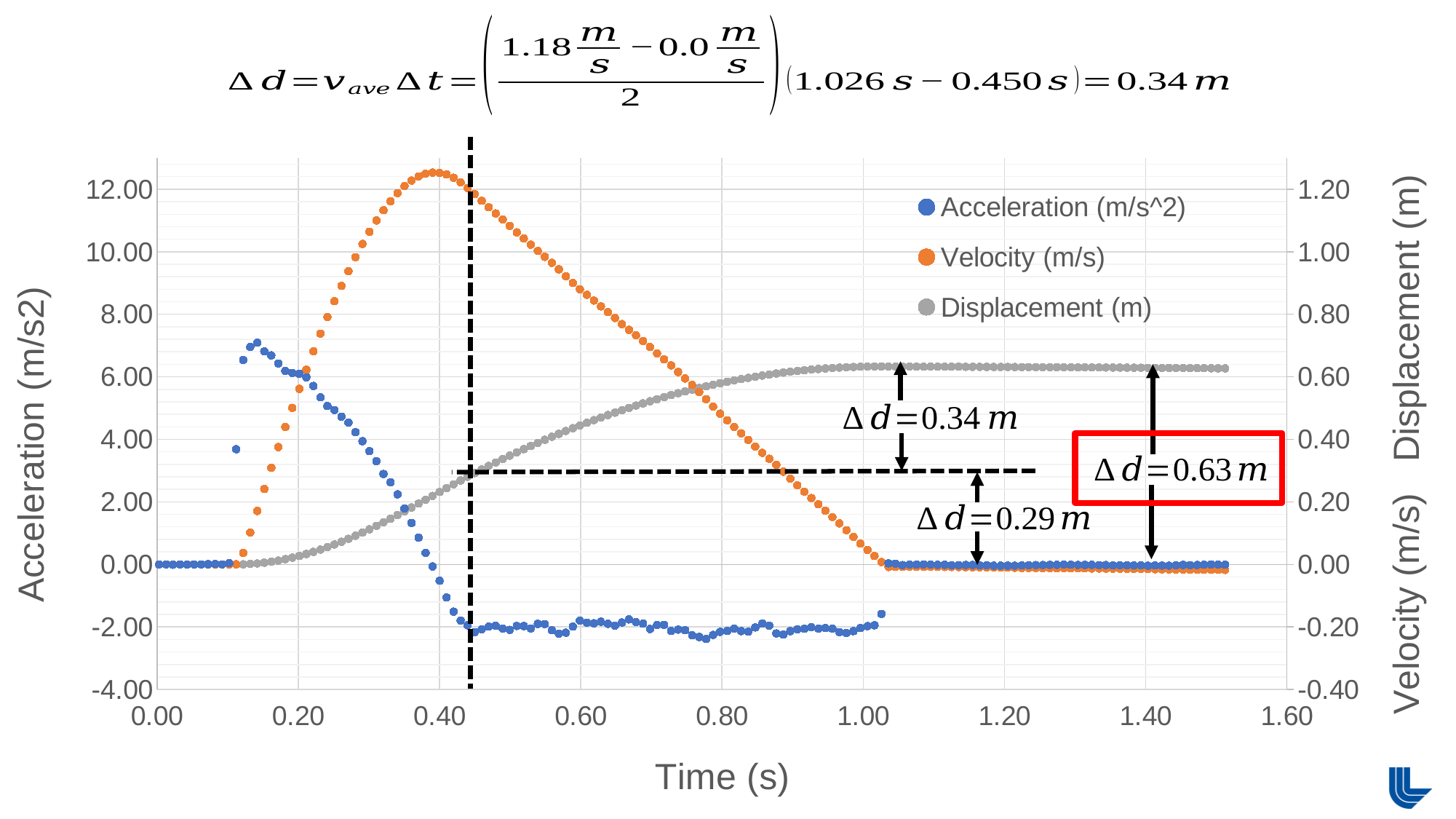
Is the peak velocity on the chart greater or less than 1.00 m/s on the right axis? greater What kind of chart is shown on the slide? scatter chart Which three series are listed in the chart legend? Acceleration (m/s^2), Velocity (m/s), Displacement (m) Is the peak acceleration on the chart greater or less than 6.00 m/s2? greater Is the acceleration at 0.60 s greater or less than 0.00 m/s2? less What total displacement value is shown in the red box on the chart? 0.63 m What is the sum of the two Δd segments (0.34 m and 0.29 m) annotated on the chart? 0.63 m What Δd value is annotated below the horizontal dashed line on the chart? 0.29 m What Δd value is annotated above the horizontal dashed line on the chart? 0.34 m How does the displacement series change along the time axis? It rises from zero and then levels off at a plateau How many series does the legend list? 3 What is the label of the horizontal axis of the chart? Time (s)